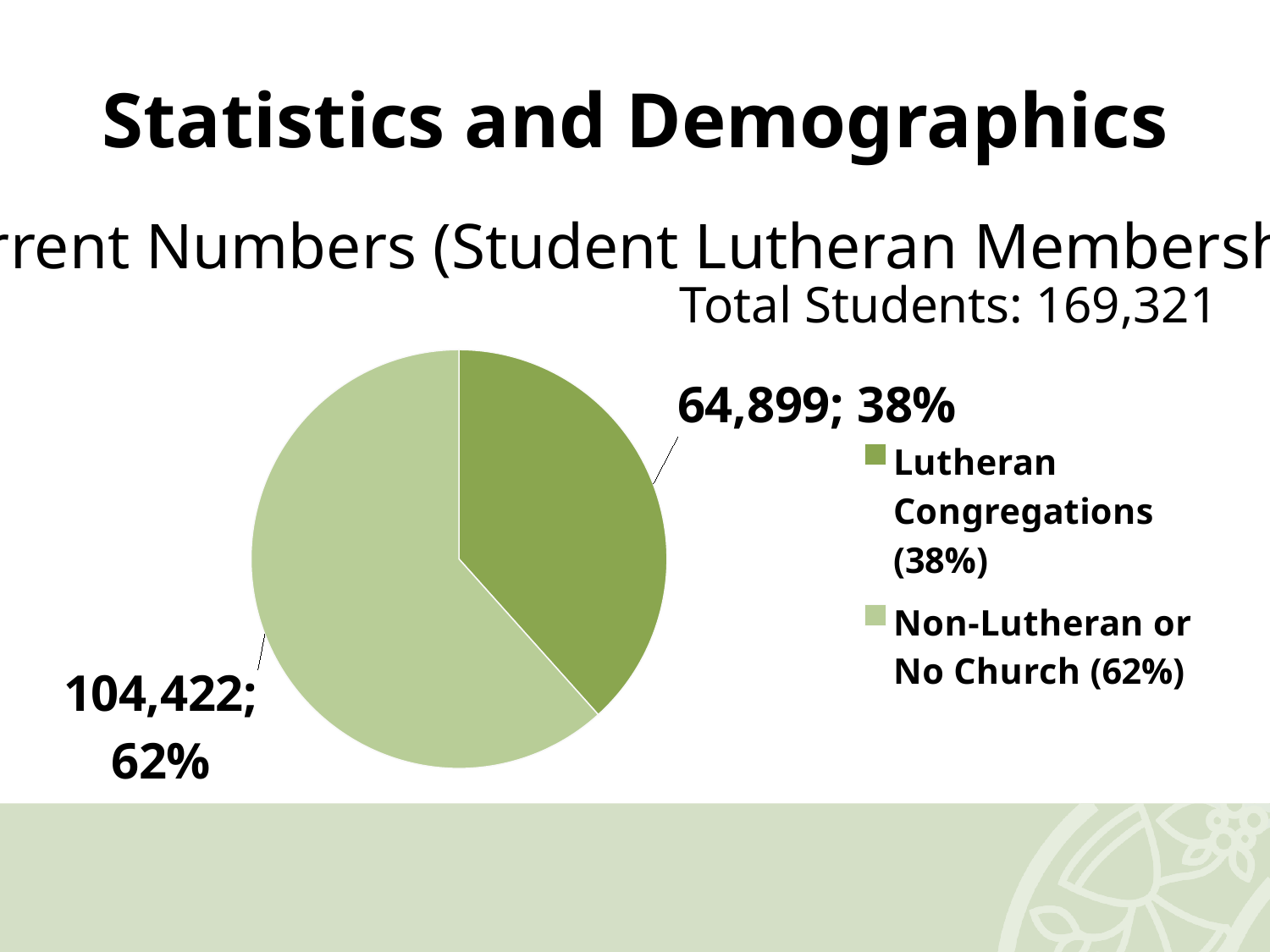
What is the value shown for the Lutheran Congregations slice? 64,899 Which is larger, the Lutheran Congregations slice or the Non-Lutheran or No Church slice? Non-Lutheran or No Church What share of the pie does the Non-Lutheran or No Church slice represent? 62% What share of the pie does the Lutheran Congregations slice represent? 38% What kind of chart is shown on the slide? pie chart Which slice is the smallest? Lutheran Congregations What total number of students is stated above the pie chart? 169,321 How many slices does the pie chart have? 2 How many entries does the legend list? 2 What is the value shown for the Non-Lutheran or No Church slice? 104,422 What is the difference between the Non-Lutheran or No Church value and the Lutheran Congregations value? 39,523 Which slice is the largest? Non-Lutheran or No Church